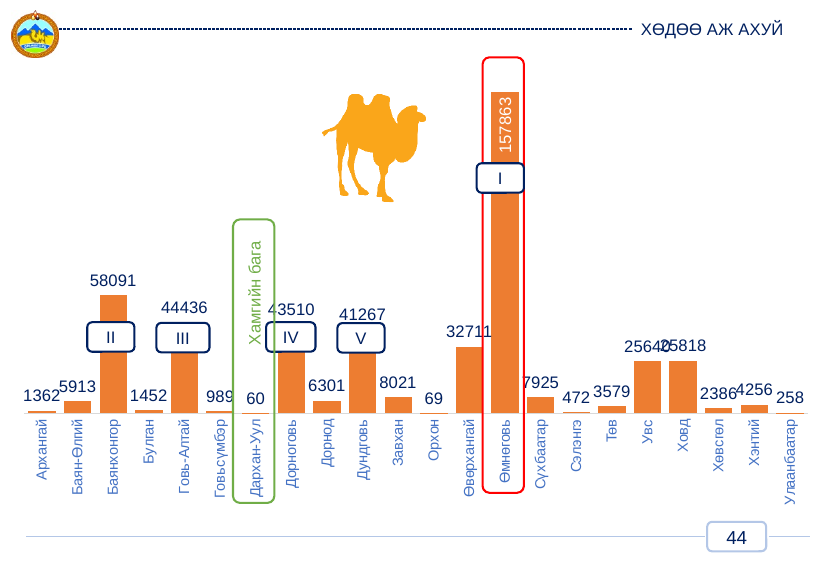
What is the value shown for Өмнөговь? 157863 Which category has the highest value? Өмнөговь What is the difference between the values for Говь-Алтай and Дорноговь? 926 What is the value shown for Дархан-Уул? 60 What kind of chart is shown on the slide? bar chart Which category has the lowest value? Дархан-Уул Which category is marked with the green box labelled 'Хамгийн бага'? Дархан-Уул What is the value shown for Өвөрхангай? 32711 How many categories are shown on the x axis? 22 What is the value shown for Баянхонгор? 58091 What is the difference between the values for Өмнөговь and Баянхонгор? 99772 Which is larger, the value for Дундговь or the value for Өвөрхангай? Дундговь